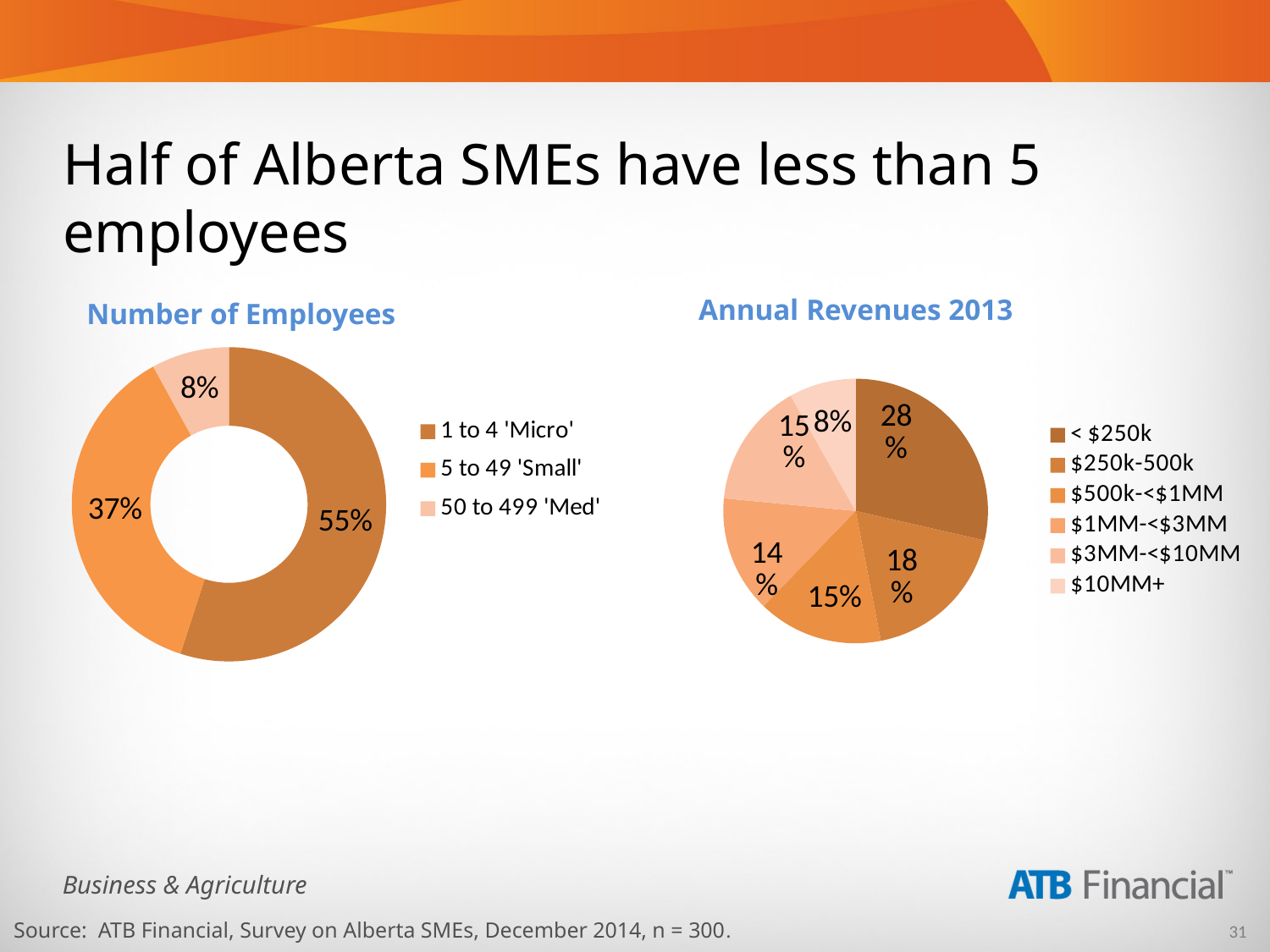
What type of chart is the Number of Employees chart? Donut chart In the Annual Revenues 2013 chart, which is larger: the $250k-500k share or the $1MM-<$3MM share? $250k-500k What type of chart is the Annual Revenues 2013 chart? Pie chart In the Annual Revenues 2013 chart, what share of SMEs had revenues under $250k? 28% In the Number of Employees chart, what share of SMEs have 50 to 499 'Med' employees? 8% In the Number of Employees chart, what is the difference between the 1 to 4 'Micro' share and the 5 to 49 'Small' share? 18 percentage points How many categories does the legend of the Number of Employees chart list? 3 How many revenue categories does the legend of the Annual Revenues 2013 chart list? 6 In the Annual Revenues 2013 chart, what share of SMEs had revenues of $10MM+? 8% In the Annual Revenues 2013 chart, which revenue category has the smallest share? $10MM+ In the Number of Employees chart, what share of SMEs have 1 to 4 'Micro' employees? 55% In the Number of Employees chart, which category has the largest share? 1 to 4 'Micro'